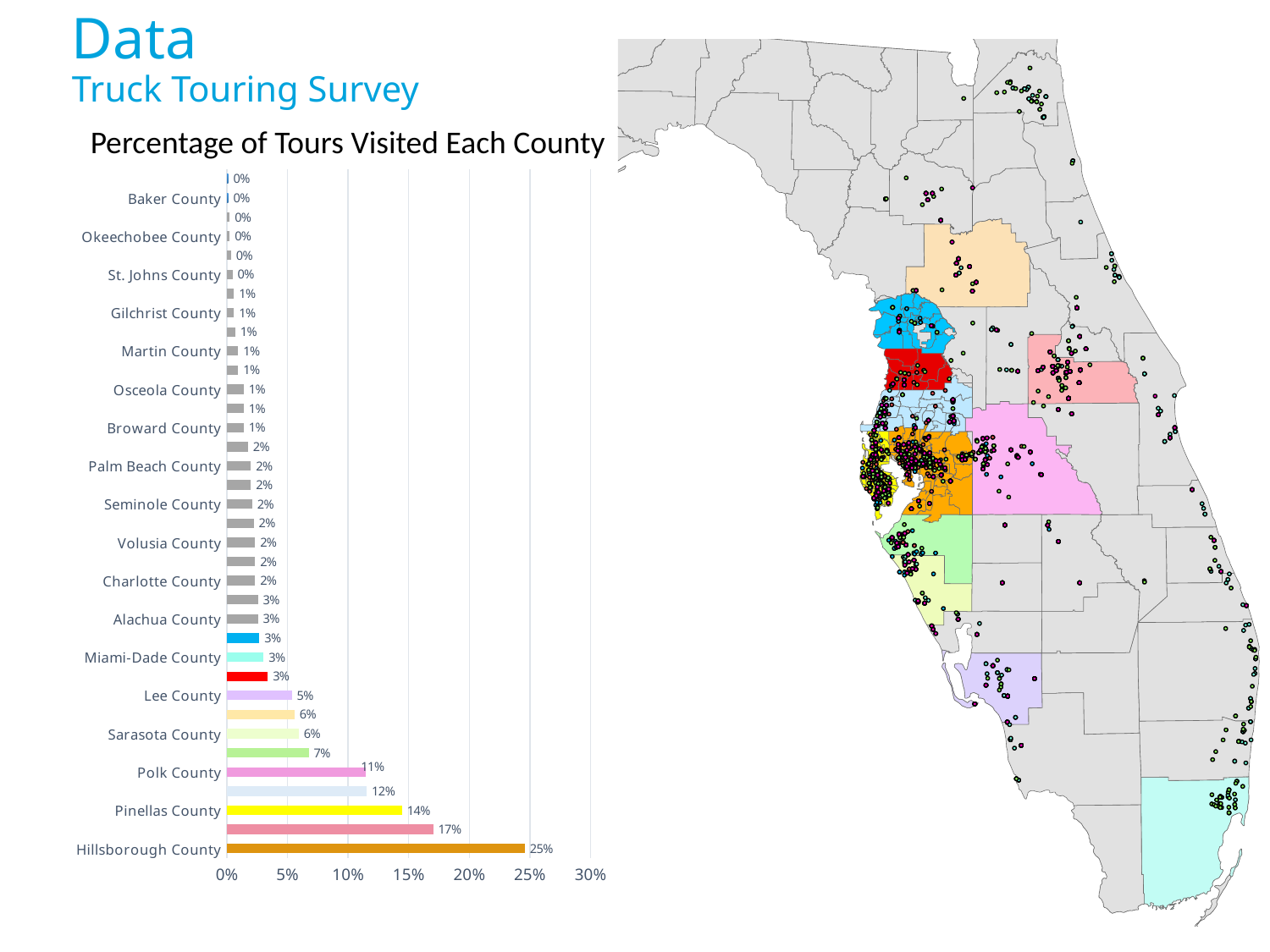
Is the value for Hillsborough County greater or less than 20%? greater What is the title of the chart? Percentage of Tours Visited Each County What percentage of tours visited Lee County? 5% What is the maximum value shown on the chart's horizontal axis? 30% What percentage of tours visited Sarasota County? 6% Which has a higher percentage of tours visited, Polk County or Lee County? Polk County Which county has the highest percentage of tours visited? Hillsborough County What kind of chart is shown on the slide? Bar chart What percentage of tours visited Pinellas County? 14% What percentage of tours visited Polk County? 11% What is the difference between the percentages for Hillsborough County and Pinellas County? 11% What percentage of tours visited Hillsborough County? 25%